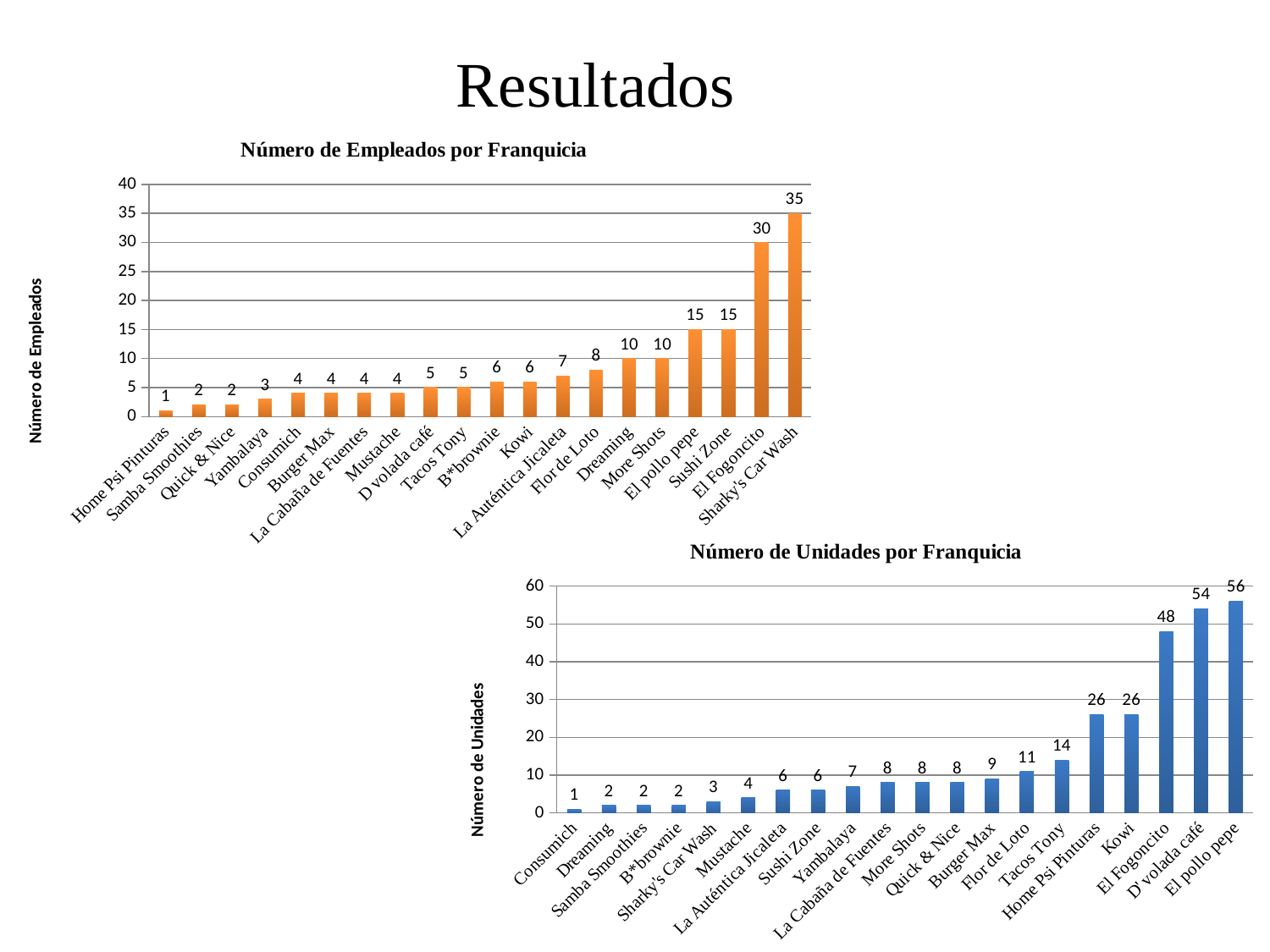
In the chart 'Número de Empleados por Franquicia', what is the difference between the values for Sharky's Car Wash and El Fogoncito? 5 In the chart 'Número de Empleados por Franquicia', do the values rise or fall from left to right? rise What type of chart is 'Número de Unidades por Franquicia'? bar chart In the chart 'Número de Empleados por Franquicia', how many franchises are shown? 20 What is the y-axis label of the chart 'Número de Unidades por Franquicia'? Número de Unidades In the chart 'Número de Empleados por Franquicia', how many employees does El Fogoncito have? 30 In the chart 'Número de Unidades por Franquicia', which franchise has the most units? El pollo pepe In the chart 'Número de Empleados por Franquicia', which franchise has the lowest number of employees? Home Psi Pinturas In the chart 'Número de Unidades por Franquicia', which is larger, the value for Tacos Tony or the value for Flor de Loto? Tacos Tony In the chart 'Número de Empleados por Franquicia', which franchise has the highest number of employees? Sharky's Car Wash In the chart 'Número de Unidades por Franquicia', what is the difference between the values for El pollo pepe and El Fogoncito? 8 In the chart 'Número de Unidades por Franquicia', how many units does D volada café have? 54